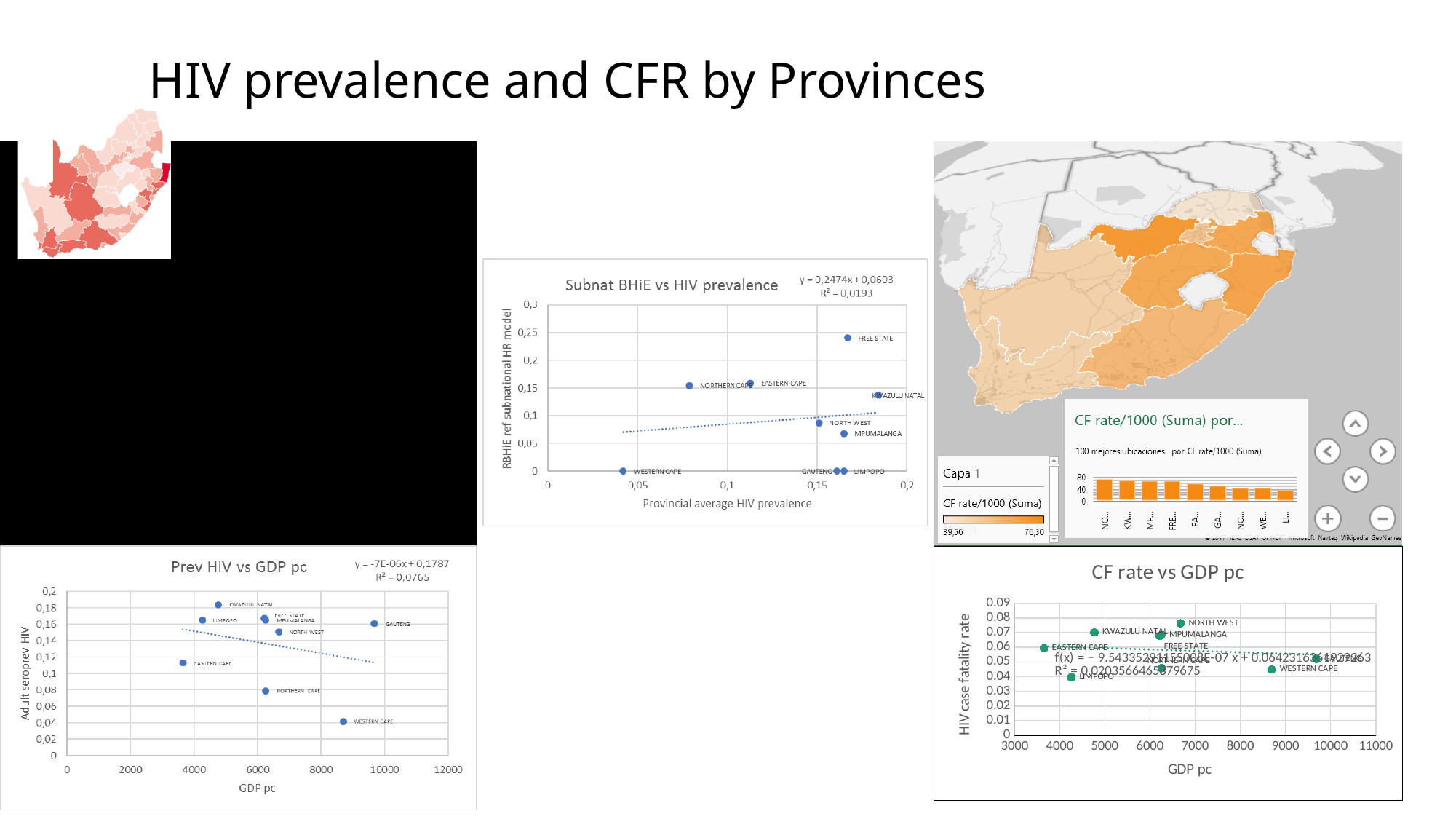
In the "Prev HIV vs GDP pc" chart, is the GDP pc for Western Cape greater or less than 8000? greater In the "Subnat BHiE vs HIV prevalence" chart, which province has the highest value on the vertical axis? Free State In the "CF rate vs GDP pc" chart, is the GDP pc for Eastern Cape greater or less than 4000? less In the "CF rate vs GDP pc" chart, which province has the lowest HIV case fatality rate? Limpopo In the "CF rate vs GDP pc" chart, which province has the highest HIV case fatality rate? North West In the "Prev HIV vs GDP pc" chart, does the trend line rise or fall as GDP pc increases? Falls What R² value is shown on the "Prev HIV vs GDP pc" chart? R² = 0,0765 What is the trend line equation shown on the "Subnat BHiE vs HIV prevalence" chart? y = 0,2474x + 0,0603 In the "Prev HIV vs GDP pc" chart, which province has the lowest adult HIV seroprevalence? Western Cape In the "Subnat BHiE vs HIV prevalence" chart, is the vertical-axis value for Free State greater or less than 0,2? greater In the "Prev HIV vs GDP pc" chart, which province has the highest adult HIV seroprevalence? Kwazulu Natal What kind of chart is the "Subnat BHiE vs HIV prevalence" chart? Scatter chart